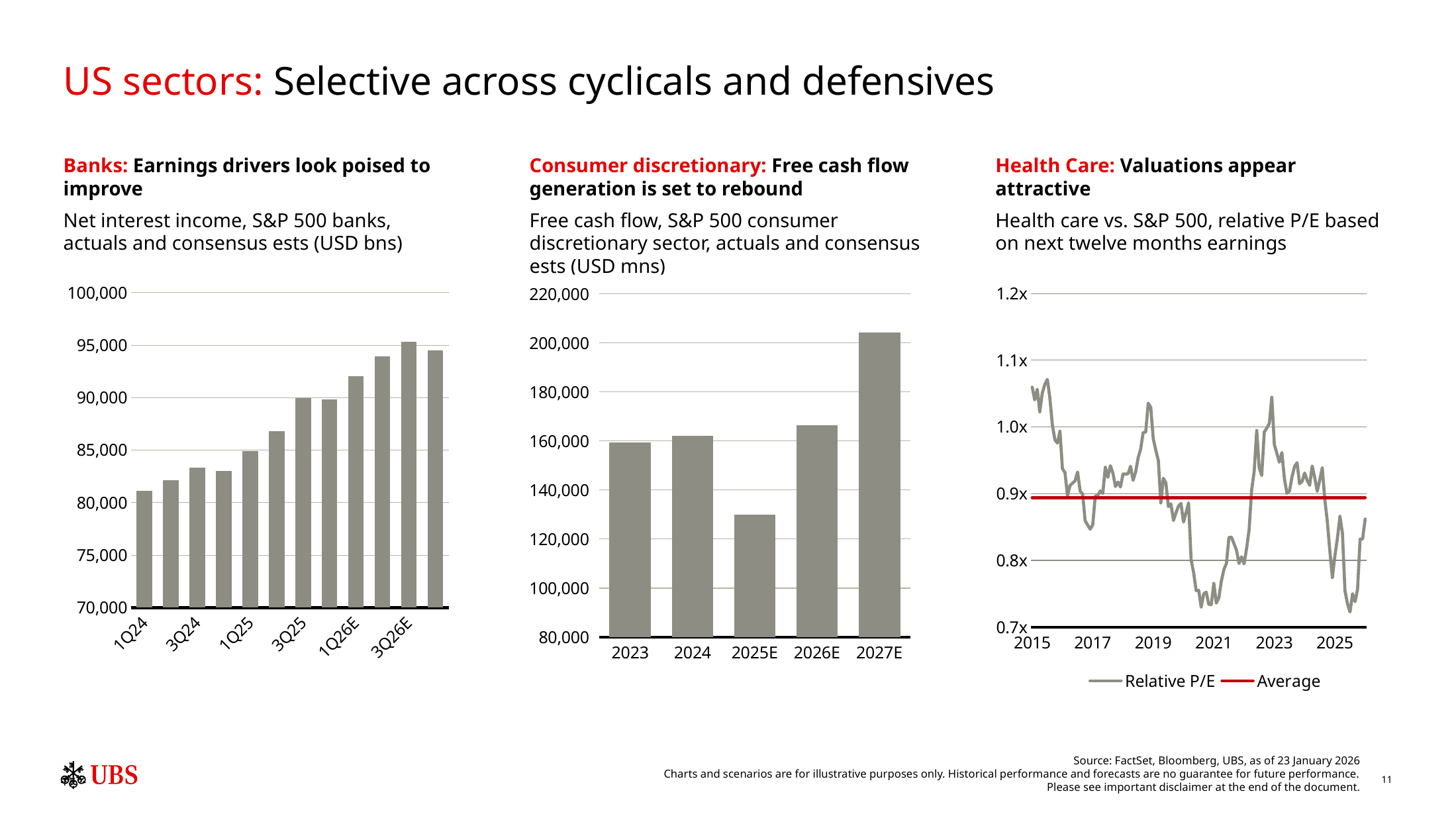
In the Consumer discretionary chart (middle), which year has the highest free cash flow? 2027E In the Consumer discretionary chart (middle), which year has the lowest free cash flow? 2025E In the Banks chart (left), do the values generally rise or fall from 1Q24 to 3Q26E? rise What kind of chart is the Banks chart (left)? bar chart In the Consumer discretionary chart (middle), how many years are shown on the x axis? 5 In the Health Care chart (right), what are the two series named in the legend? Relative P/E and Average In the Consumer discretionary chart (middle), which is larger, the value for 2027E or the value for 2026E? 2027E In the Banks chart (left), is the value for 1Q24 greater or less than 85,000? less In the Banks chart (left), which quarter has the lowest net interest income? 1Q24 How many series does the legend of the Health Care chart (right) list? 2 In the Consumer discretionary chart (middle), is the value for 2025E greater or less than 140,000? less What kind of chart is the Consumer discretionary chart (middle)? bar chart